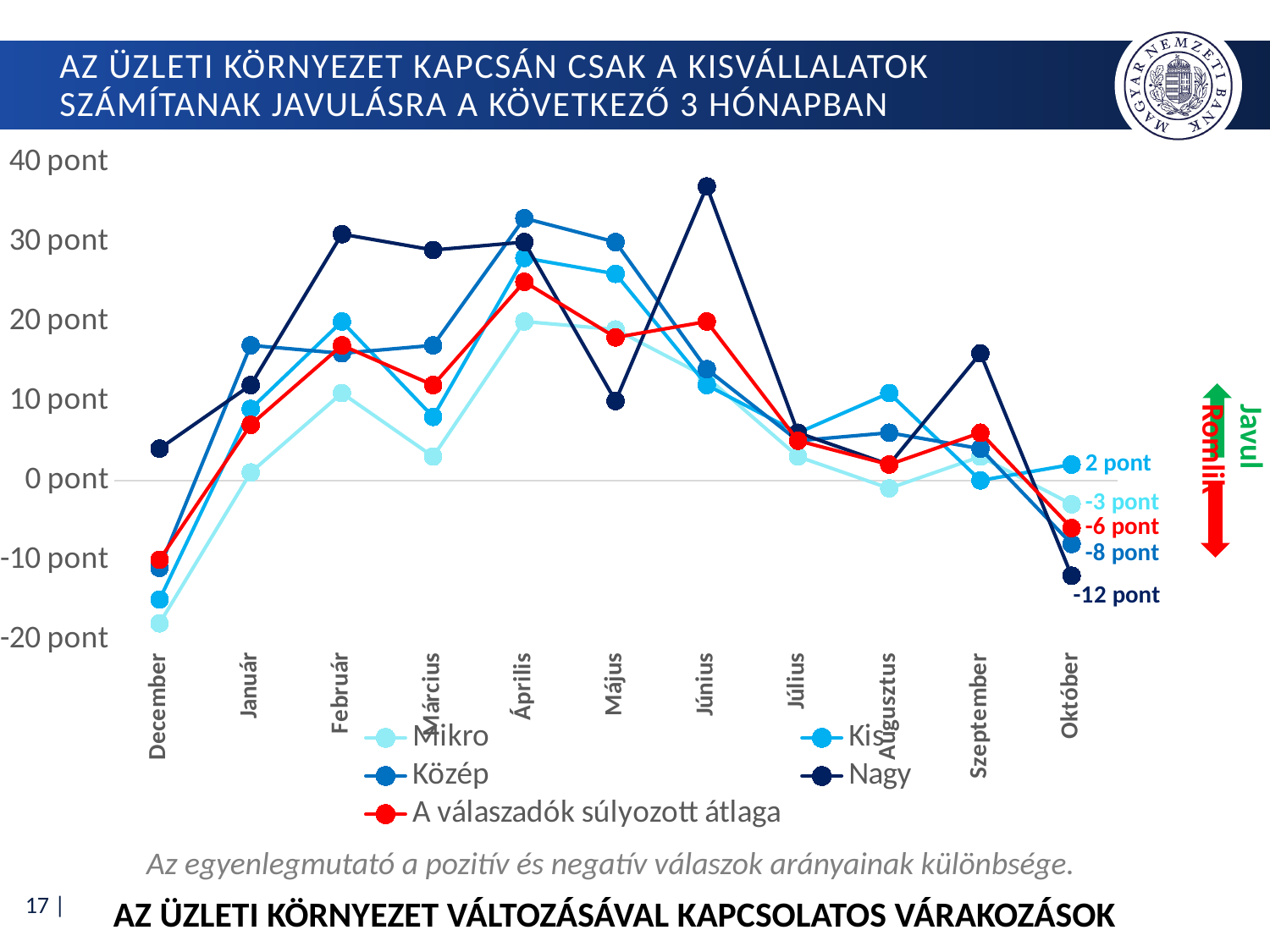
Is the value for Nagy in Június greater or less than 30 pont? greater In Október, which is larger: the value for Mikro or the value for Közép? Mikro What is the value for A válaszadók súlyozott átlaga in Október? -6 pont What is the value for Kis in Október? 2 pont What is the value for Nagy in Október? -12 pont How many months are shown on the x axis? 11 What kind of chart is shown on the slide? line chart Is the value for Mikro in December greater or less than -10 pont? less How many series does the legend list? 5 Which series has the highest value in Október? Kis What is the difference between the Kis and Nagy values in Október? 14 pont Which series has the lowest value in Október? Nagy